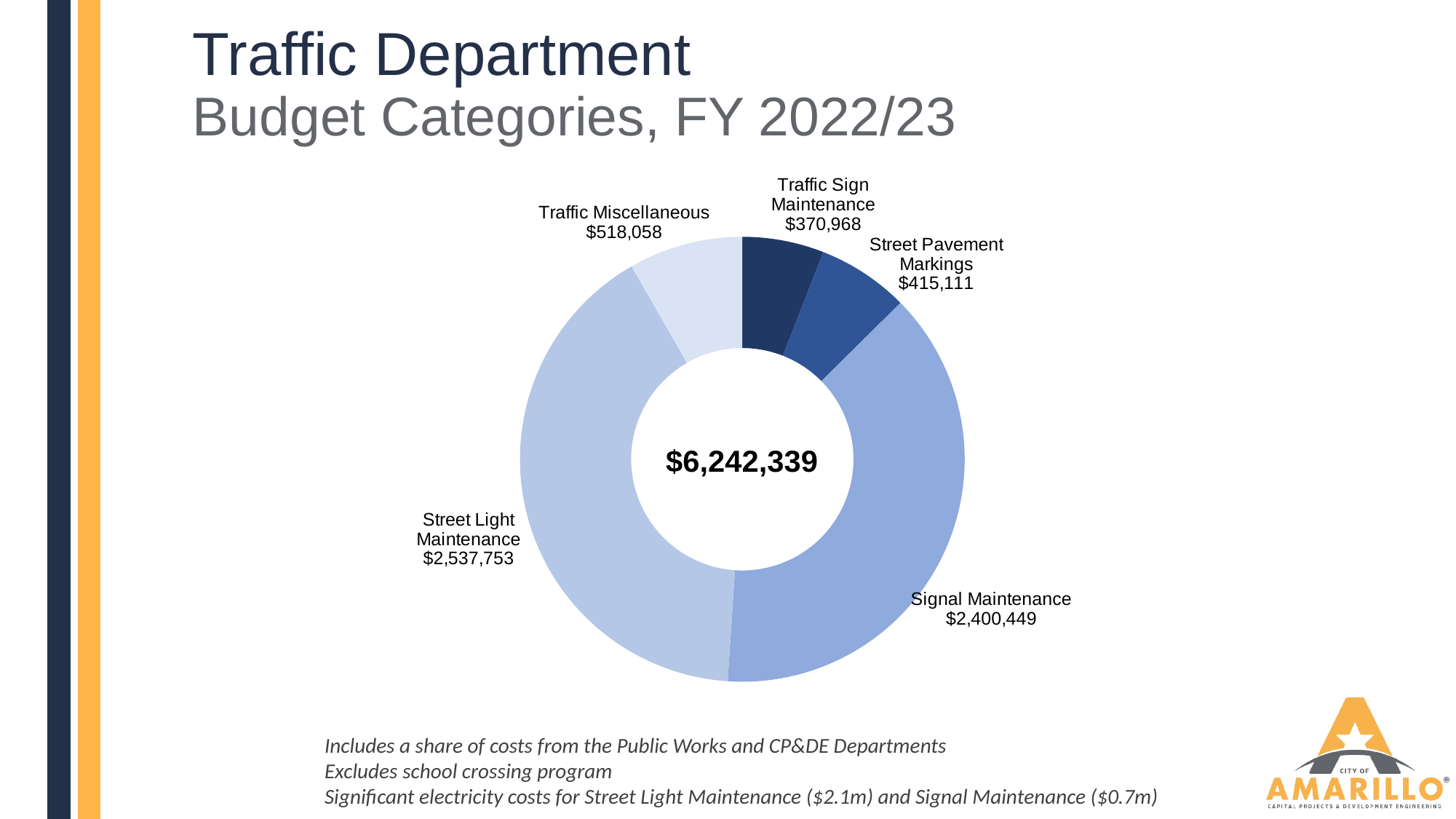
What is the budget value for Traffic Sign Maintenance? $370,968 Which is larger, Street Pavement Markings or Traffic Sign Maintenance? Street Pavement Markings What is the difference between Street Light Maintenance and Signal Maintenance? $137,304 What kind of chart is shown on the slide? Pie chart (donut) What is the budget value for Street Pavement Markings? $415,111 Which budget category has the largest value? Street Light Maintenance How many budget categories are shown in the chart? 5 What is the difference between Traffic Miscellaneous and Traffic Sign Maintenance? $147,090 What is the budget value for Signal Maintenance? $2,400,449 What is the budget value for Traffic Miscellaneous? $518,058 What total value is shown in the center of the chart? $6,242,339 Which budget category has the smallest value? Traffic Sign Maintenance